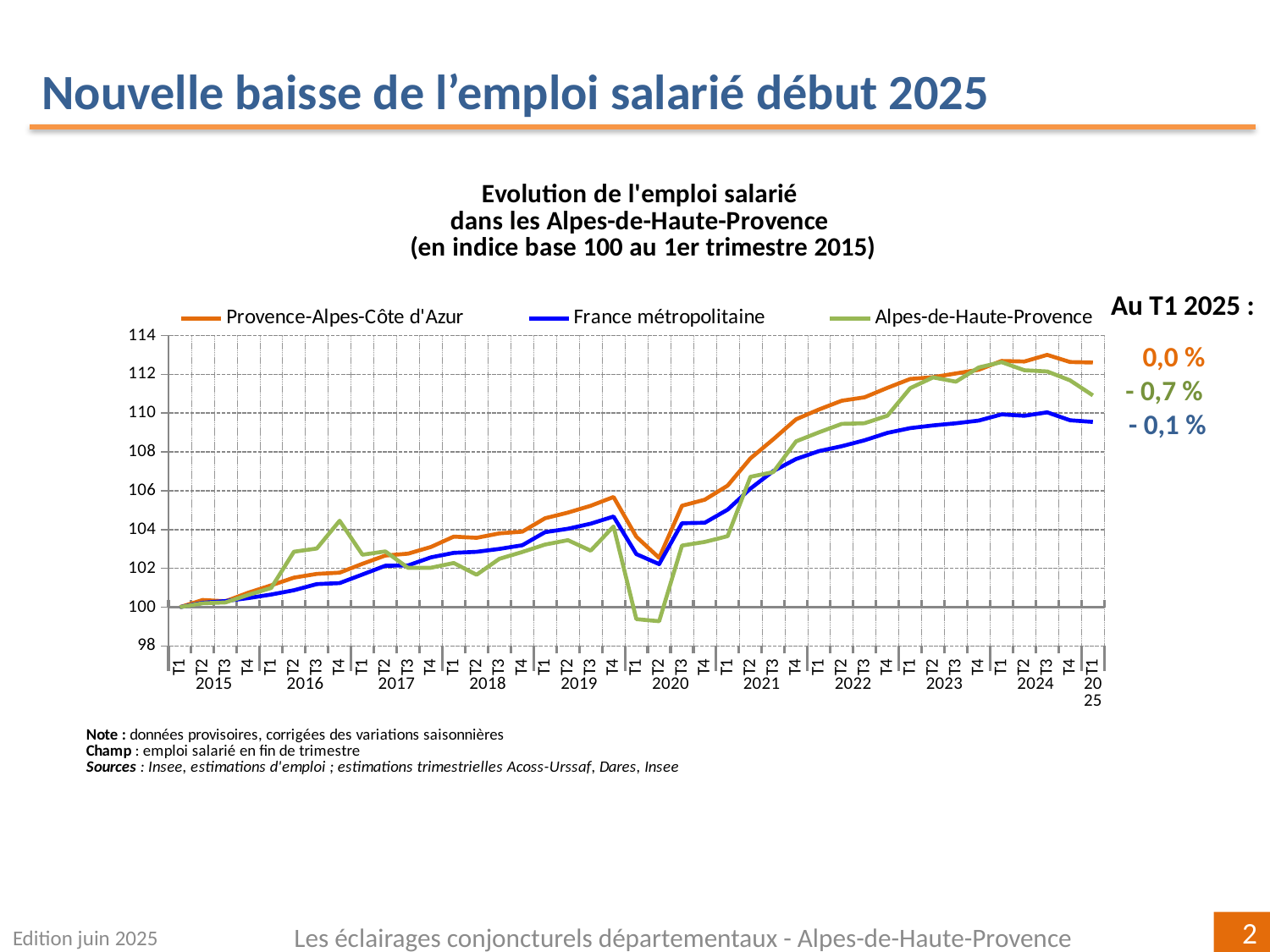
Does the France métropolitaine series rise or fall between T1 2015 and T4 2019? rise At T1 2020, which is higher: France métropolitaine or Alpes-de-Haute-Provence? France métropolitaine Which series has the lowest value at T1 2020? Alpes-de-Haute-Provence What kind of chart is shown on the slide? line chart Which series has the highest value at T1 2025? Provence-Alpes-Côte d'Azur Is the value for Alpes-de-Haute-Provence at T1 2020 greater or less than 100? less Is the value for Provence-Alpes-Côte d'Azur at T3 2024 greater or less than 112? greater What is the index value of all three series at T1 2015? 100 How many series does the legend list? 3 What is the title of the chart? Evolution de l'emploi salarié dans les Alpes-de-Haute-Provence (en indice base 100 au 1er trimestre 2015) Is the value for France métropolitaine at T1 2025 greater or less than 110? less According to the annotation on the right, what is the change for Alpes-de-Haute-Provence at T1 2025? - 0,7 %